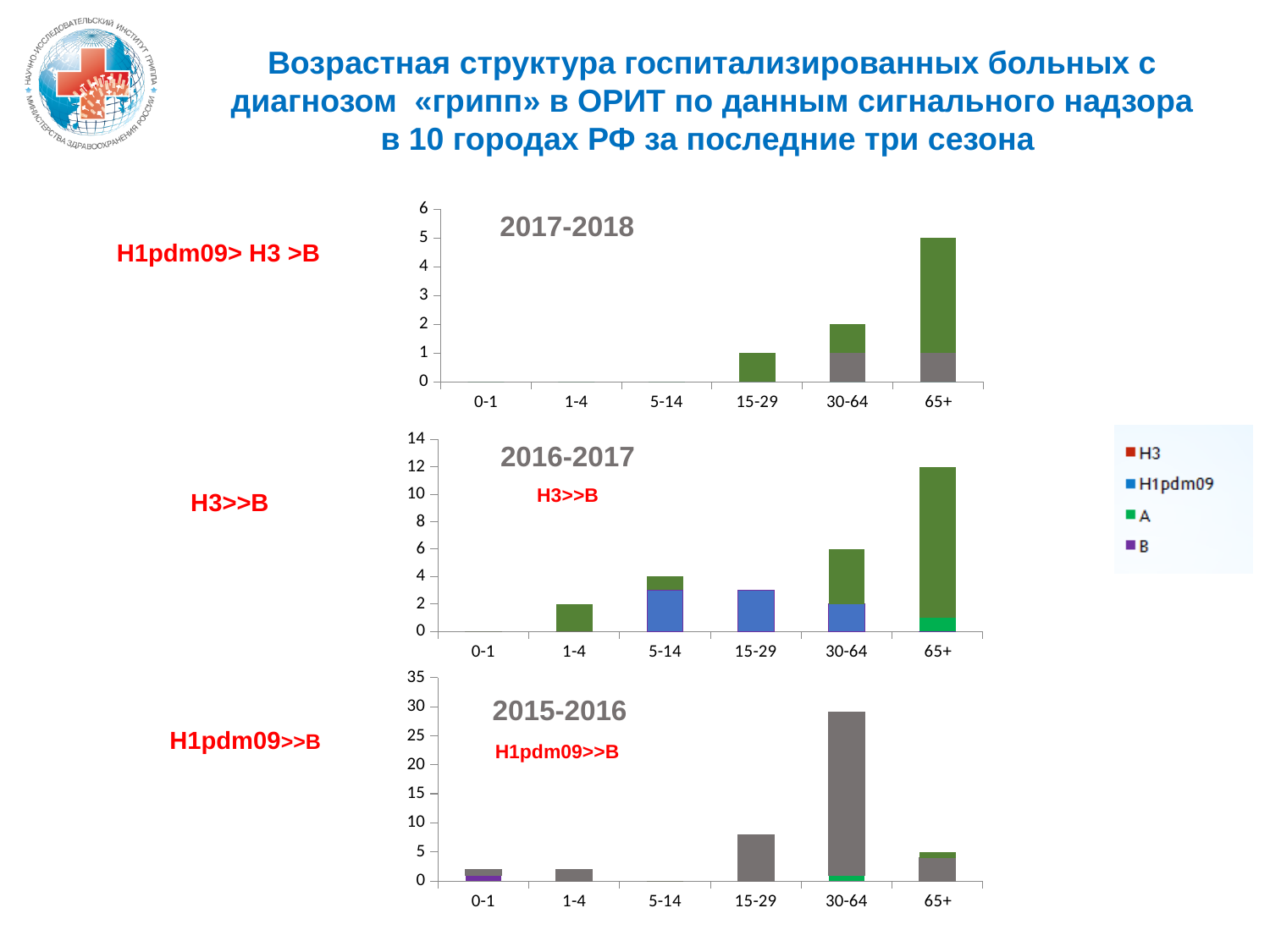
In the 2016-2017 chart, what is the total height of the bar for 65+? 12 How many age categories are shown on the x axis of the 2015-2016 chart? 6 In the 2016-2017 chart, which bar is taller, 30-64 or 5-14? 30-64 In the 2015-2016 chart, which bar is taller, 15-29 or 65+? 15-29 What kind of chart is the 2017-2018 chart? bar chart In the 2017-2018 chart, which age category has the tallest bar? 65+ In the 2015-2016 chart, which age category has the tallest bar? 30-64 In the 2017-2018 chart, what is the total height of the bar for 30-64? 2 In the 2015-2016 chart, is the total for 30-64 greater or less than 25? greater How many series does the legend list? 4 In the 2016-2017 chart, which age category has the tallest bar? 65+ In the 2017-2018 chart, what is the total height of the bar for 65+? 5